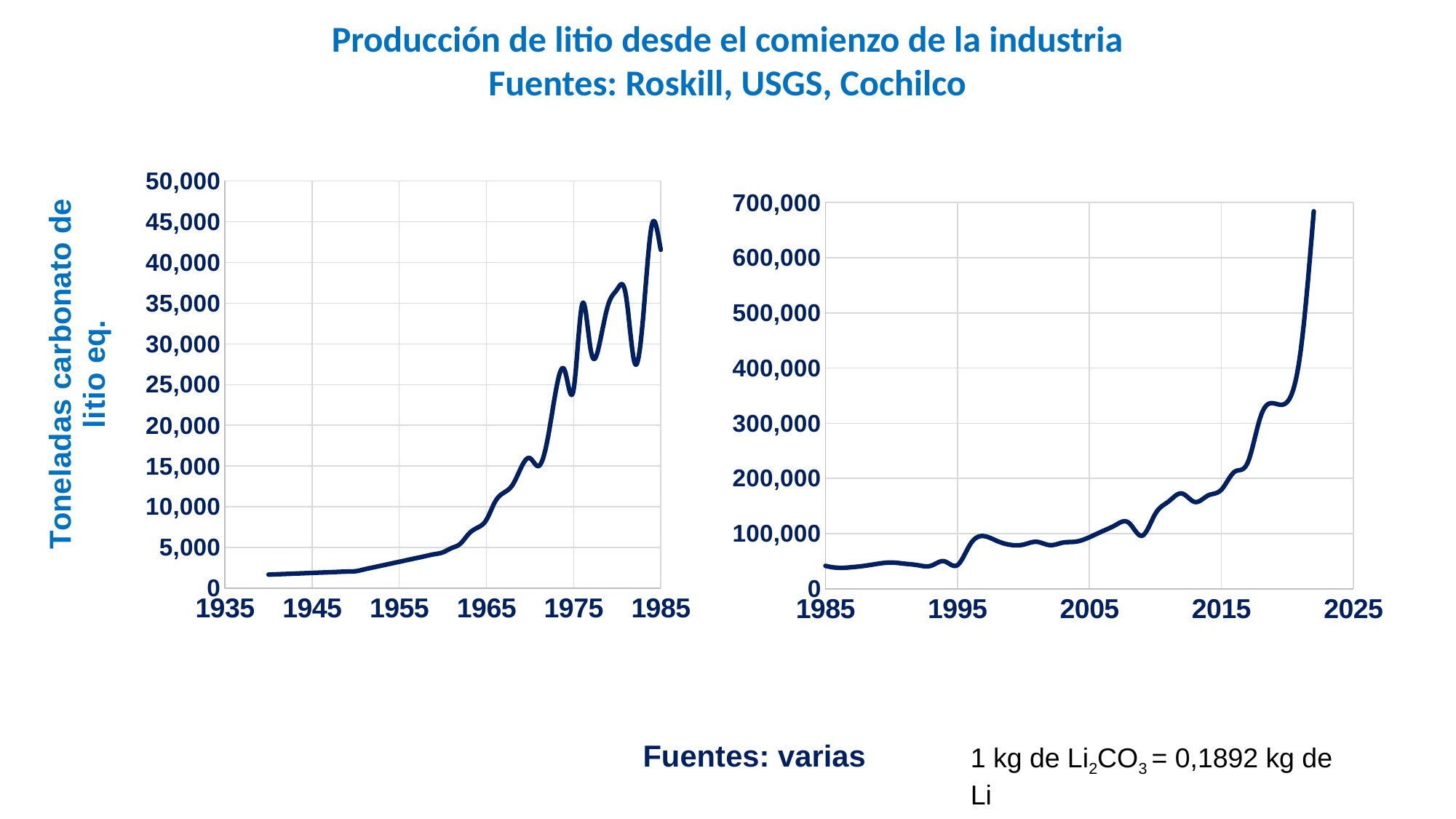
On the right chart (1985–2025), is the last plotted value greater or less than 600,000? greater What kind of chart is the left chart (1935–1985)? line chart On the left chart (1935–1985), is the value for 1965 greater or less than 5,000? greater What kind of chart is the right chart (1985–2025)? line chart On the right chart (1985–2025), is the value for 2015 greater or less than 150,000? greater What is the title of the slide's chart? Producción de litio desde el comienzo de la industria On the left chart (1935–1985), do the values generally rise or fall from 1935 to 1985? rise On the right chart (1985–2025), do the values generally rise or fall from 1985 to the end of the series? rise What is the label on the vertical axis of the left chart? Toneladas carbonato de litio eq.